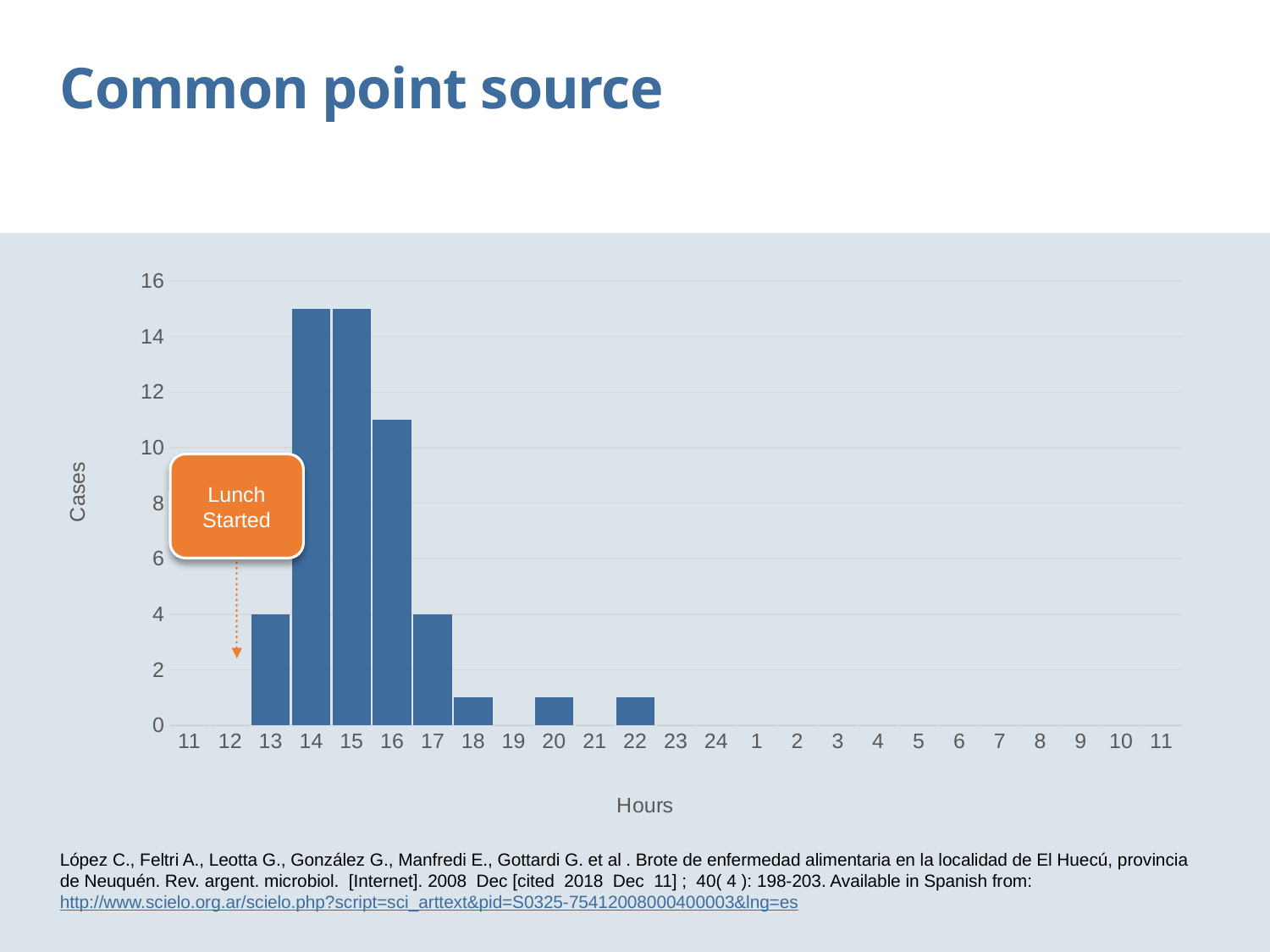
Which has more cases, hour 16 or hour 17? hour 16 Do the values rise or fall from hour 16 to hour 18? fall What type of chart is shown on the slide? bar chart Which has more cases, hour 13 or hour 14? hour 14 What is the label on the vertical axis? Cases Is the value for hour 16 greater or less than 10? greater How many hours on the x axis have a bar with cases? 8 Is the value for hour 18 greater or less than 2? less What is the number of cases at hour 17? 4 What is the number of cases at hour 13? 4 Is the value for hour 22 greater or less than 2? less